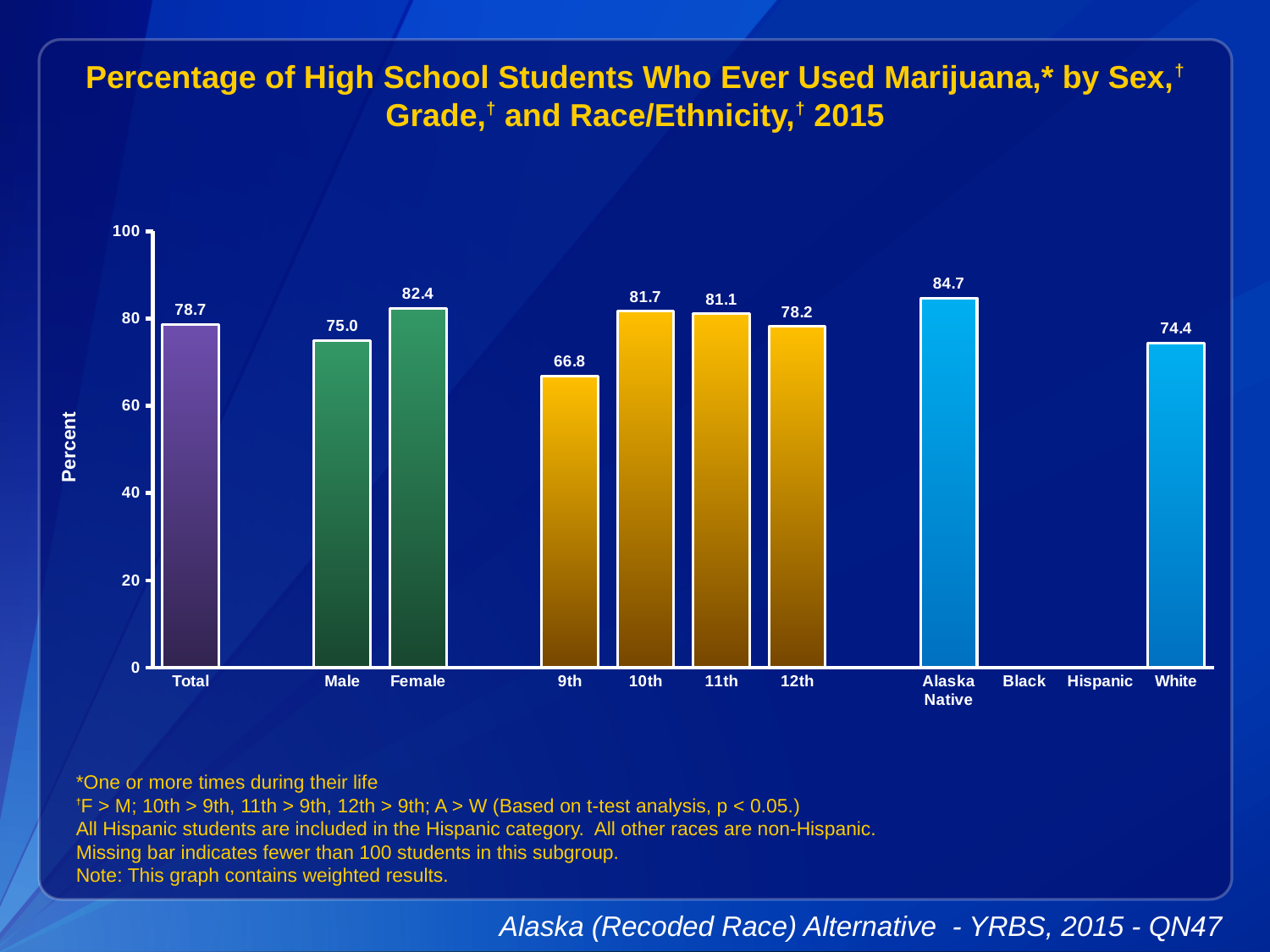
Which is larger, the value for 10th grade or 12th grade? 10th What is the value for 9th grade? 66.8 Which category has the lowest value among the bars shown? 9th How many categories have a bar plotted? 9 Is the value for White greater or less than 80? less Which category has the highest value? Alaska Native What kind of chart is this? bar chart What is the value for Alaska Native? 84.7 What is the label on the y axis? Percent What is the value for Female? 82.4 What is the value for Total? 78.7 What is the difference between the Female and Male values? 7.4